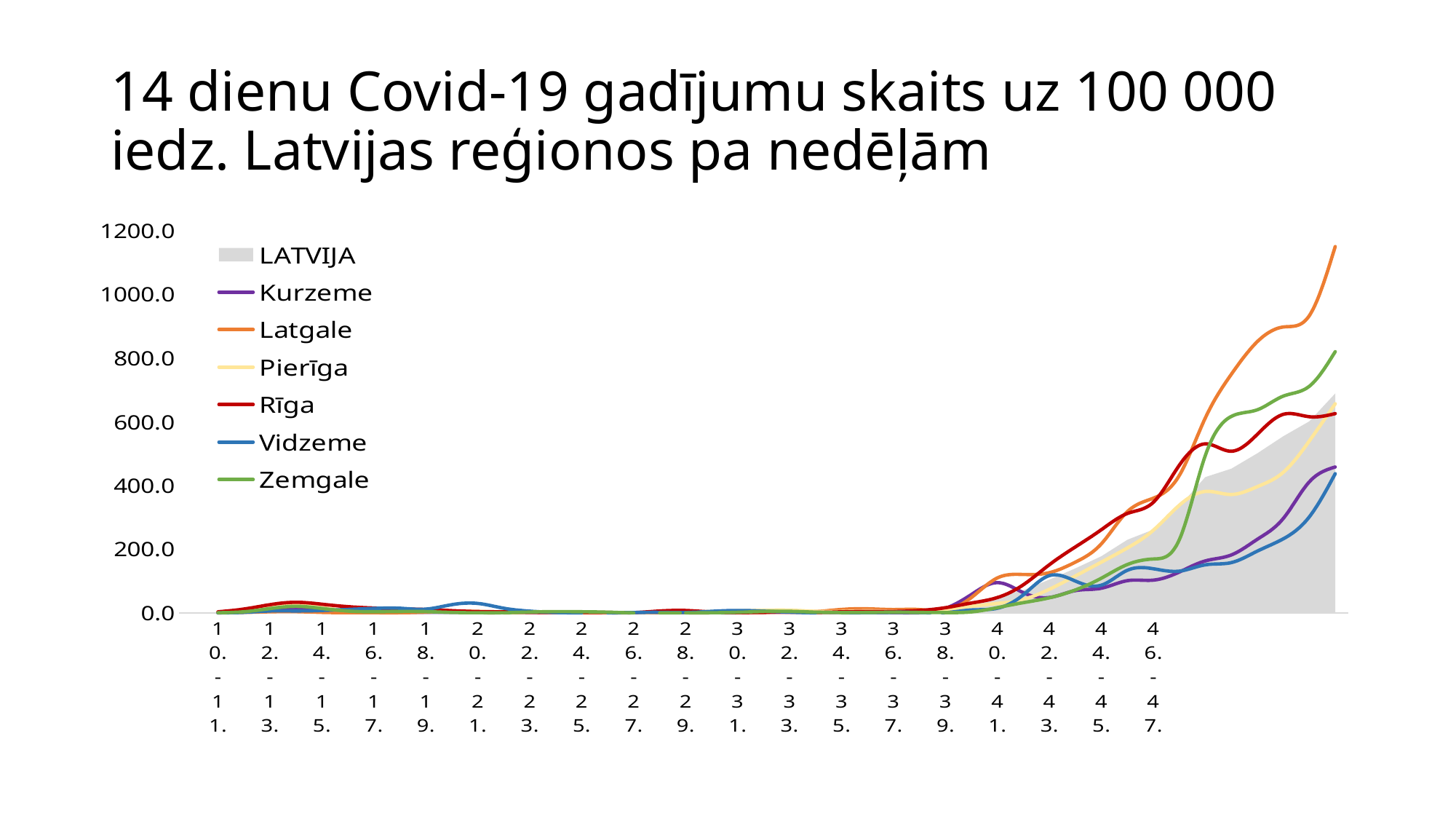
At the right end of the chart, is the value for Kurzeme greater or less than 600.0? less At the right end of the chart, is the value for Latgale greater or less than 1000.0? greater How many series does the legend list? 7 Which region has the highest value at the right end of the chart? Latgale At the right end of the chart, which is larger, the value for Zemgale or the value for Kurzeme? Zemgale At the right end of the chart, is the value for Zemgale greater or less than 600.0? greater Do the values for Latgale rise or fall along the x axis overall? rise What kind of chart is shown on the slide? combination area and line chart At the right end of the chart, which is larger, the value for Latgale or the value for Rīga? Latgale What is the title of the chart? 14 dienu Covid-19 gadījumu skaits uz 100 000 iedz. Latvijas reģionos pa nedēļām Which series is shown as a grey shaded area? LATVIJA